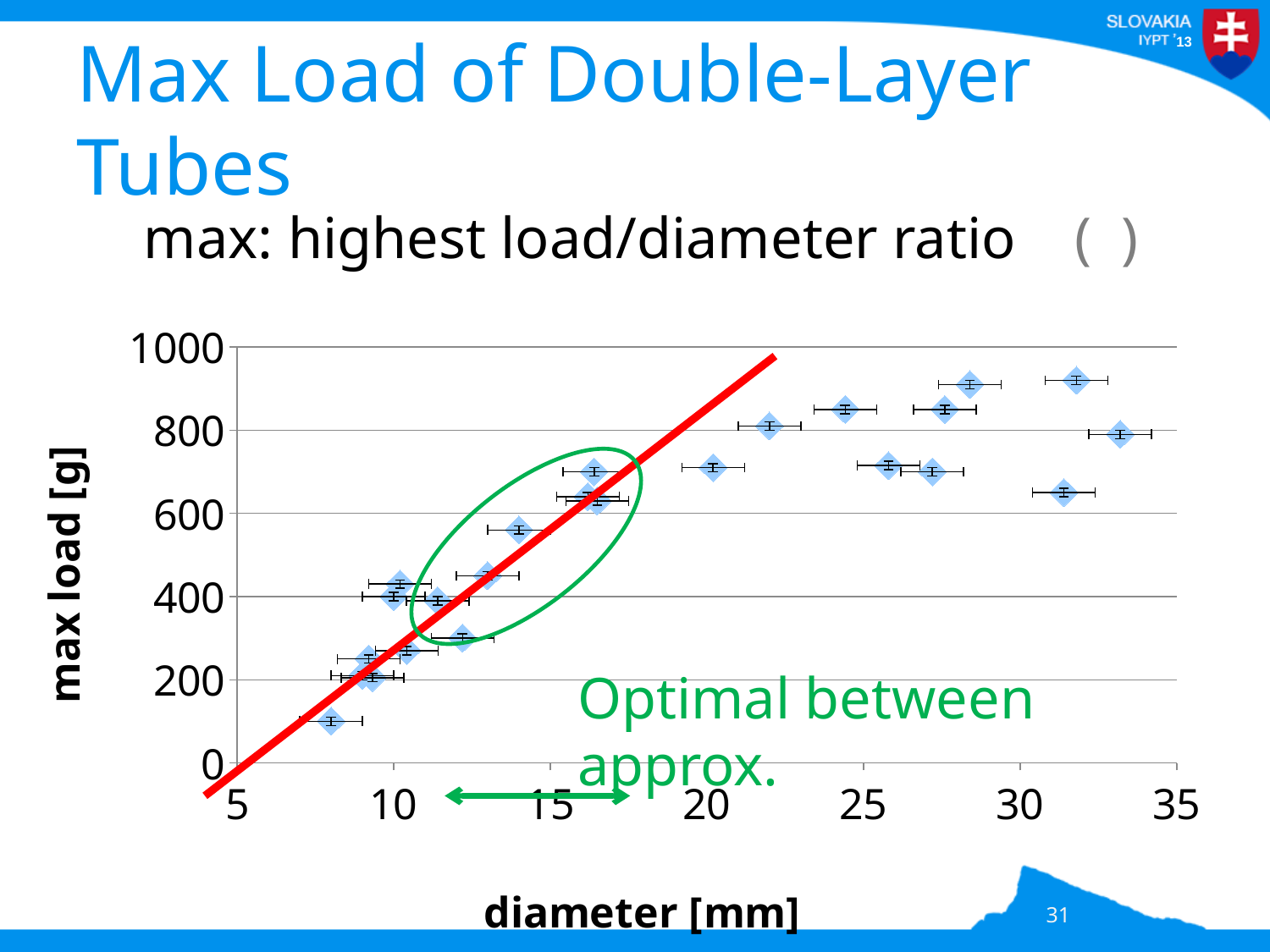
What kind of chart is shown on the slide? scatter chart Is the max load of the point at a diameter of about 20 mm greater or less than 600? greater What is the highest value shown on the y axis of the chart? 1000 Is the highest plotted max load greater or less than 800? greater Which has the larger max load: the point at a diameter of about 8 mm or the point at a diameter of about 32 mm? the point at about 32 mm What is the label of the x axis of the chart? diameter [mm] Is the max load of the point at a diameter of about 14 mm greater or less than 400? greater Overall, does the max load rise or fall as the diameter increases along the x axis? rise What is the label of the y axis of the chart? max load [g]